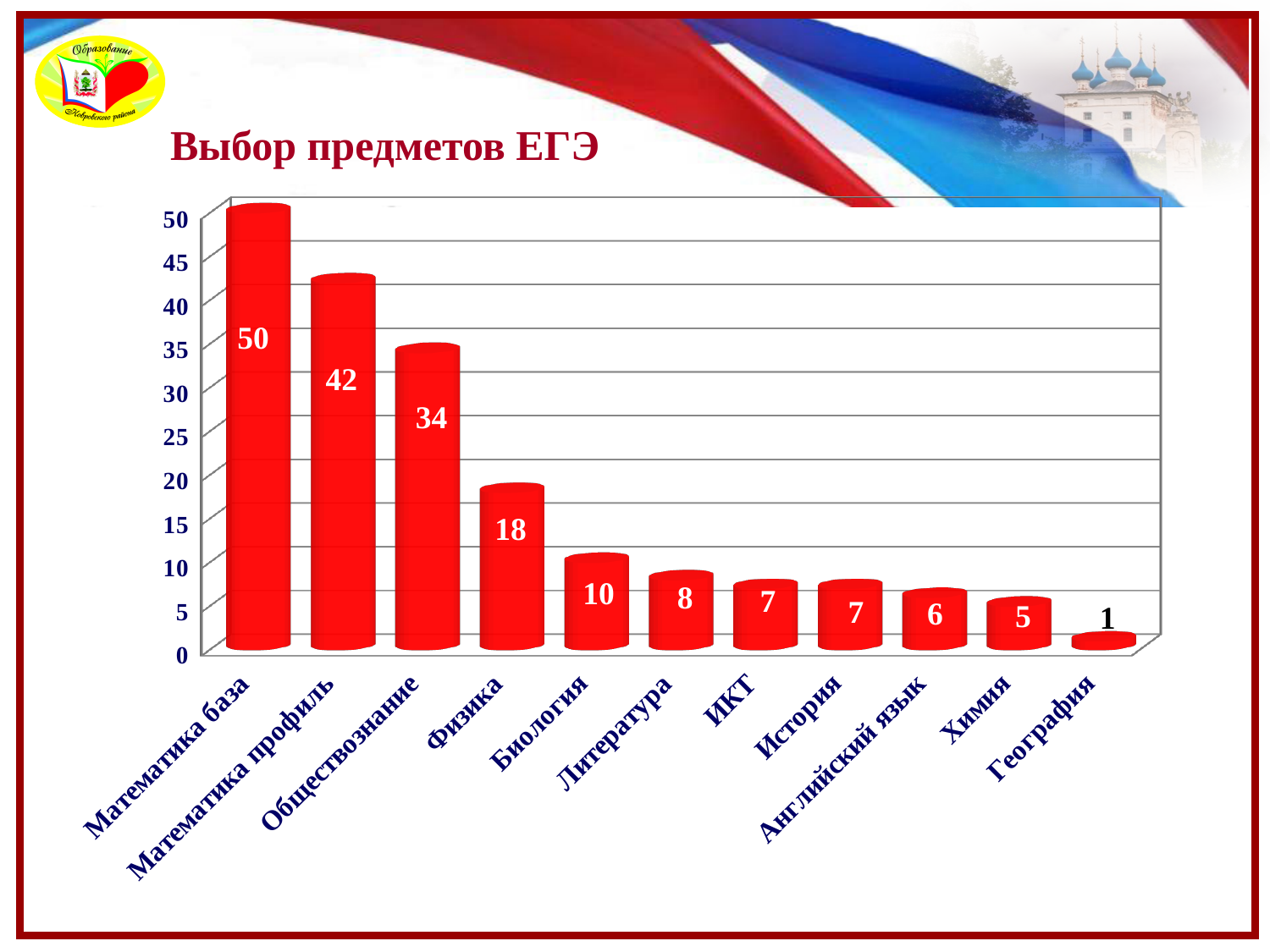
What is the title of the chart? Выбор предметов ЕГЭ Which subject has the lowest value? География Which subject has the highest value? Математика база What is the value for Физика? 18 What is the difference between the values for Физика and Биология? 8 How many subjects are shown on the chart? 11 What is the value for Английский язык? 6 What is the difference between the values for Математика база and Математика профиль? 8 What is the value for Обществознание? 34 What is the value for Математика база? 50 What kind of chart is shown on the slide? Bar chart Which is larger, the value for Литература or the value for Химия? Литература